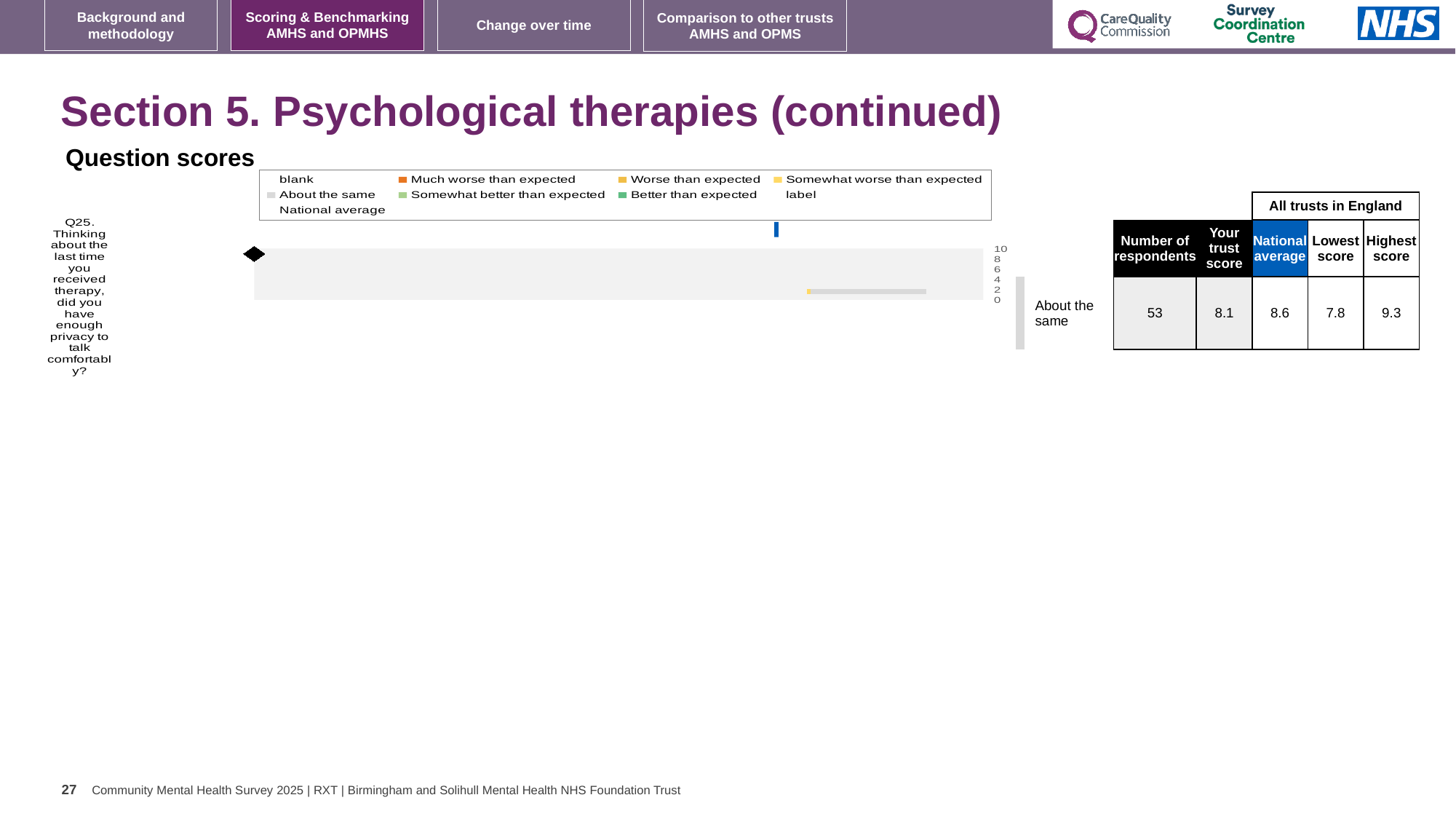
Which question number is plotted in the Question scores chart? Q25 For Q25, what is the difference between the highest score and the lowest score among all trusts in England? 1.5 What kind of chart is shown under 'Question scores'? bar chart What is the number of respondents for Q25? 53 For Q25, which is larger: the trust score or the national average? national average How many survey questions are plotted in the Question scores chart? 1 What is the lowest score among all trusts in England for Q25? 7.8 What benchmark category is shown next to the chart for Q25? About the same What is the trust score for Q25? 8.1 What is the highest score among all trusts in England for Q25? 9.3 How many entries does the legend of the Question scores chart list? 9 What is the national average score for Q25? 8.6